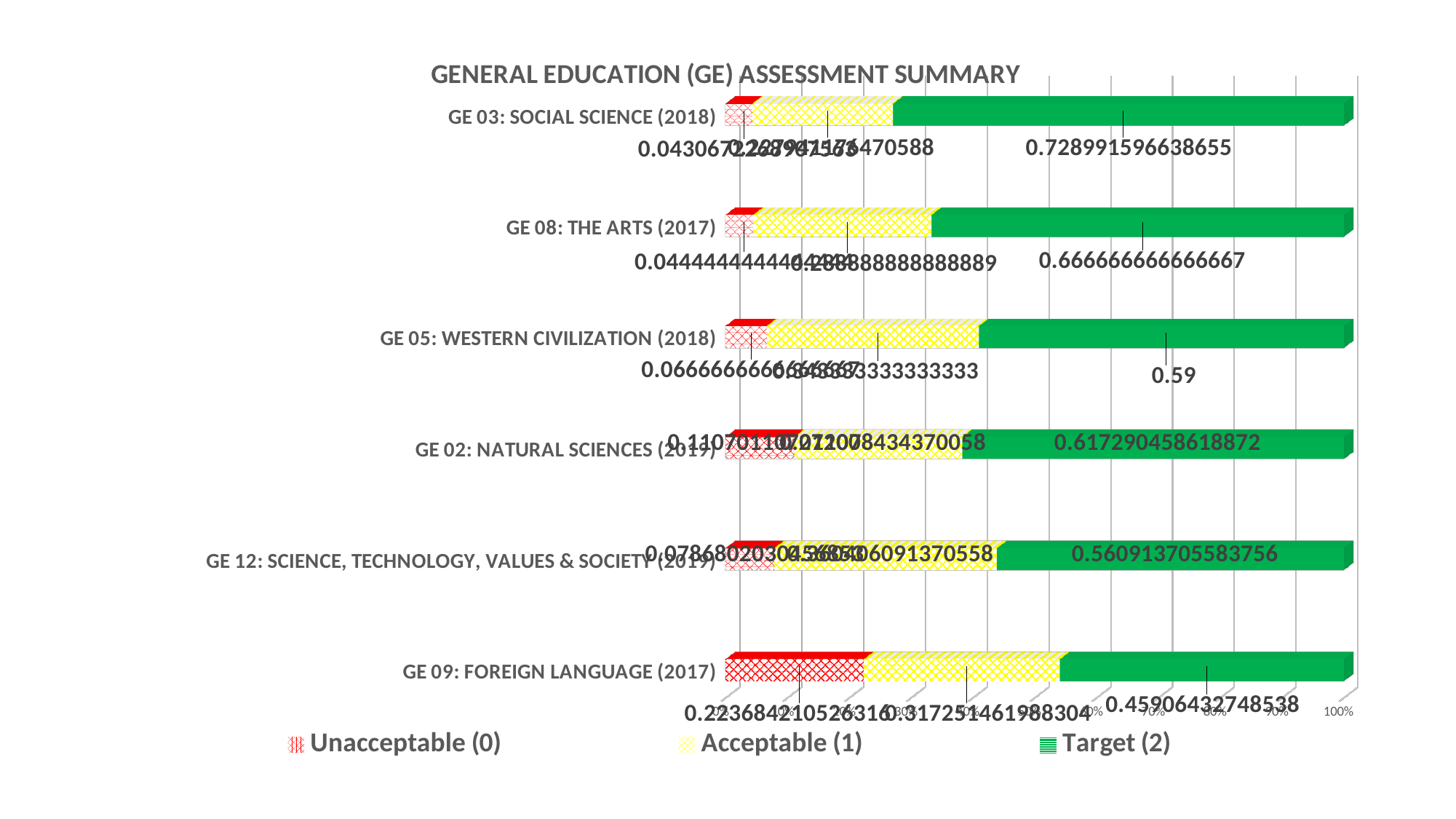
What is the Target (2) value for GE 09: FOREIGN LANGUAGE (2017)? 0.45906432748538 Which category has the lowest Target (2) value? GE 09: FOREIGN LANGUAGE (2017) What kind of chart is shown on the slide? bar chart How many GE categories are plotted on the chart? 6 What is the Target (2) value for GE 03: SOCIAL SCIENCE (2018)? 0.728991596638655 How many series does the legend list? 3 Which category has the highest Target (2) value? GE 03: SOCIAL SCIENCE (2018) What is the title of the chart? GENERAL EDUCATION (GE) ASSESSMENT SUMMARY What is the Target (2) value for GE 05: WESTERN CIVILIZATION (2018)? 0.59 Is the Target (2) share for GE 09: FOREIGN LANGUAGE (2017) greater or less than 50%? less